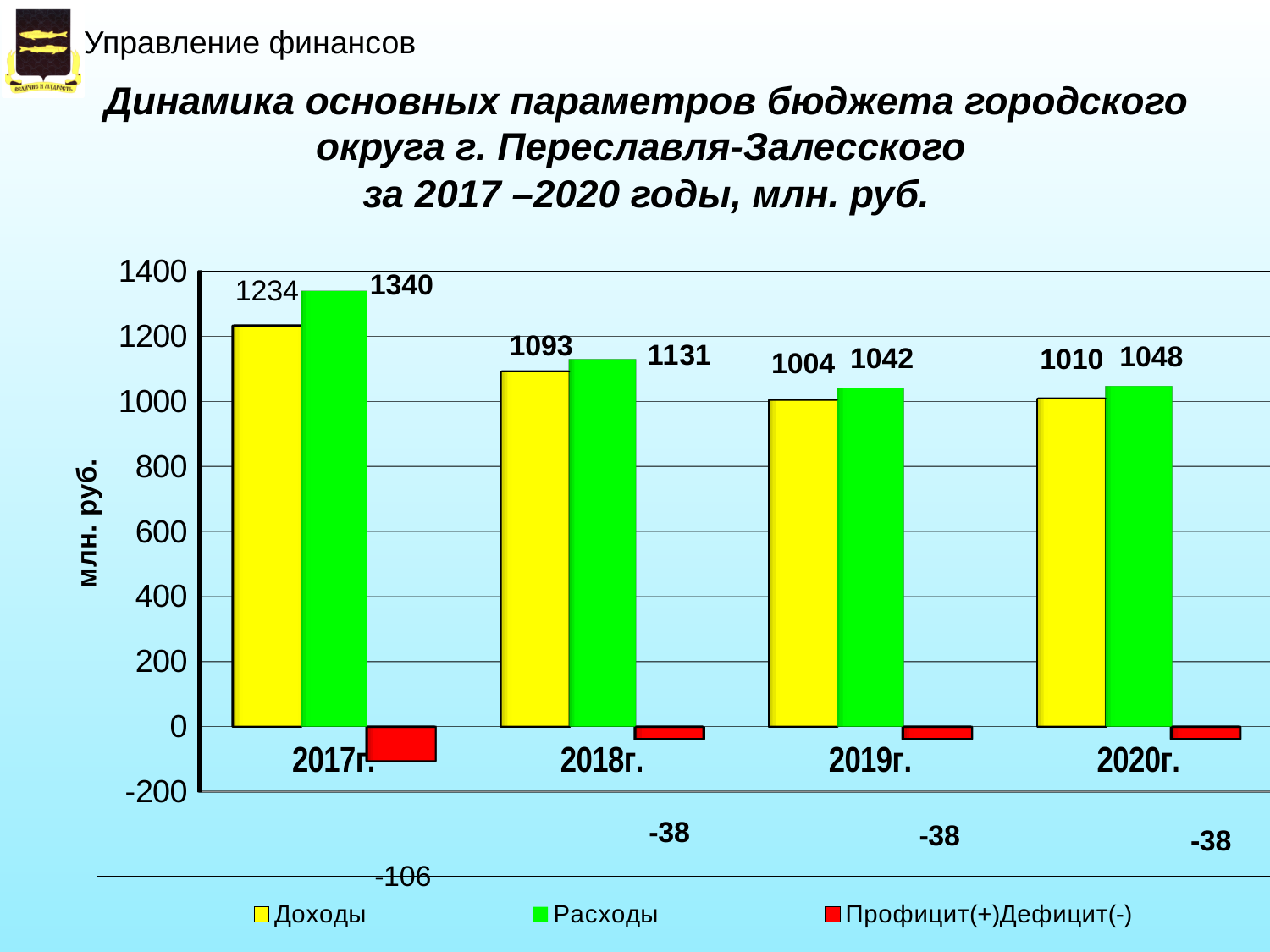
What is the value of Доходы for 2017г.? 1234 What is the value of Расходы for 2020г.? 1048 In which year is Доходы the lowest? 2019г. What kind of chart is shown on the slide? bar chart What is the value of Профицит(+)Дефицит(-) for 2017г.? -106 Does Доходы rise or fall from 2017г. to 2019г.? fall In which year is Расходы the highest? 2017г. How many years are shown on the x axis? 4 What is the difference between Расходы and Доходы in 2018г.? 38 What is the label of the y axis? млн. руб. Which is larger in 2019г., Доходы or Расходы? Расходы How many series does the legend list? 3